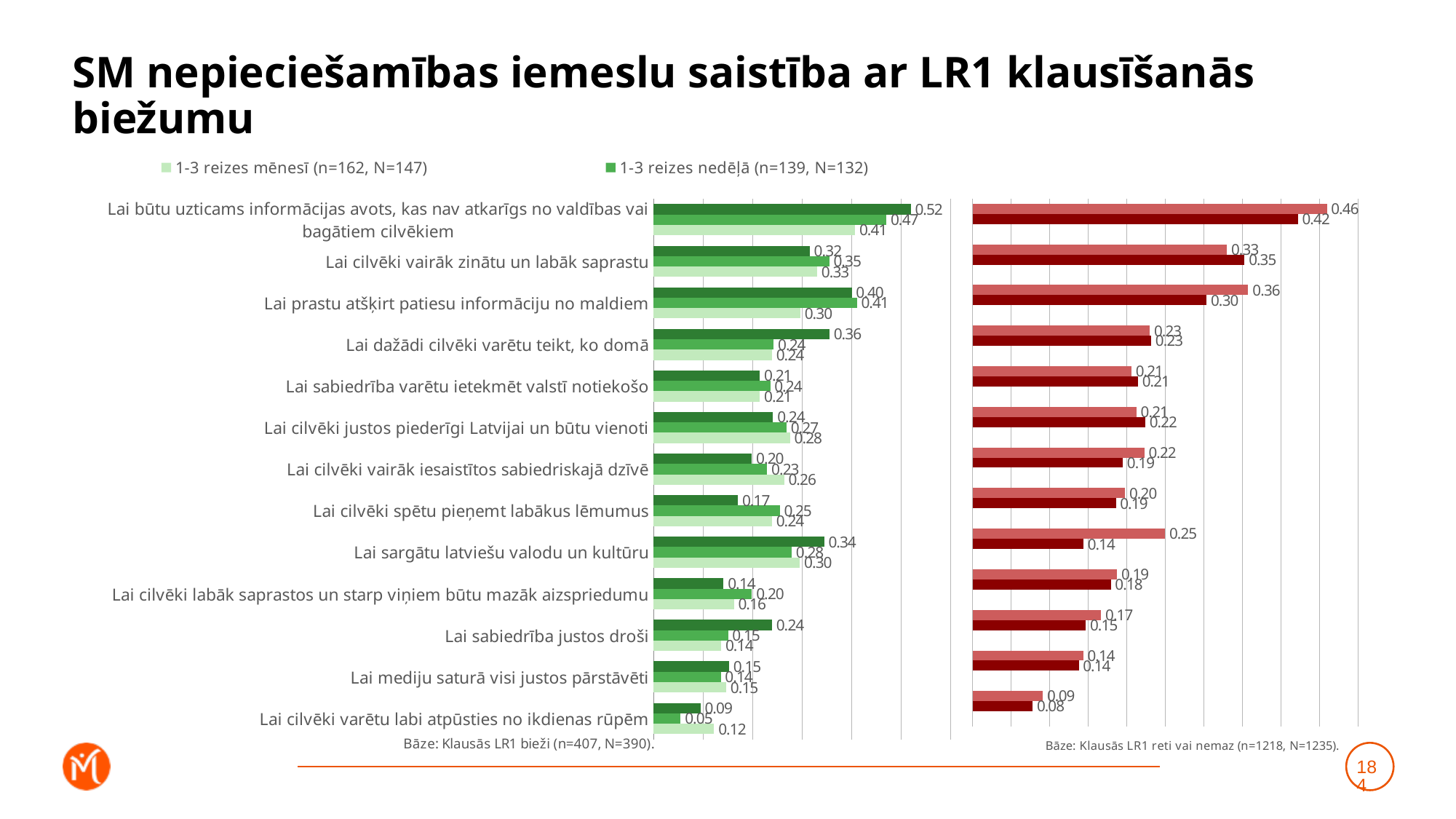
On the left chart, what is the difference between the '1-3 reizes nedēļā' and '1-3 reizes mēnesī' values for 'Lai būtu uzticams informācijas avots, kas nav atkarīgs no valdības vai bagātiem cilvēkiem'? 0.06 What base (Bāze) is stated below the right chart? Klausās LR1 reti vai nemaz (n=1218, N=1235) On the left chart, what is the value of the '1-3 reizes mēnesī' series for 'Lai cilvēki varētu labi atpūsties no ikdienas rūpēm'? 0.12 What kind of chart is shown on the left side of the slide? bar chart How many series does the legend above the left chart list? 2 On the right chart, what is the value of the upper (lighter red) bar for 'Lai sargātu latviešu valodu un kultūru'? 0.25 On the left chart, for 'Lai sabiedrība justos droši', which is larger: the '1-3 reizes nedēļā' value or the '1-3 reizes mēnesī' value? 1-3 reizes nedēļā On the left chart, which category has the highest value for the '1-3 reizes mēnesī' series? Lai būtu uzticams informācijas avots, kas nav atkarīgs no valdības vai bagātiem cilvēkiem On the left chart, which category has the lowest value for the '1-3 reizes mēnesī' series? Lai cilvēki varētu labi atpūsties no ikdienas rūpēm How many categories (reasons) are listed on the left chart? 13 On the right chart, what is the value of the lower (darker red) bar for the top category, 'Lai būtu uzticams informācijas avots, kas nav atkarīgs no valdības vai bagātiem cilvēkiem'? 0.42 On the left chart, what is the value of the '1-3 reizes nedēļā' series for 'Lai prastu atšķirt patiesu informāciju no maldiem'? 0.41